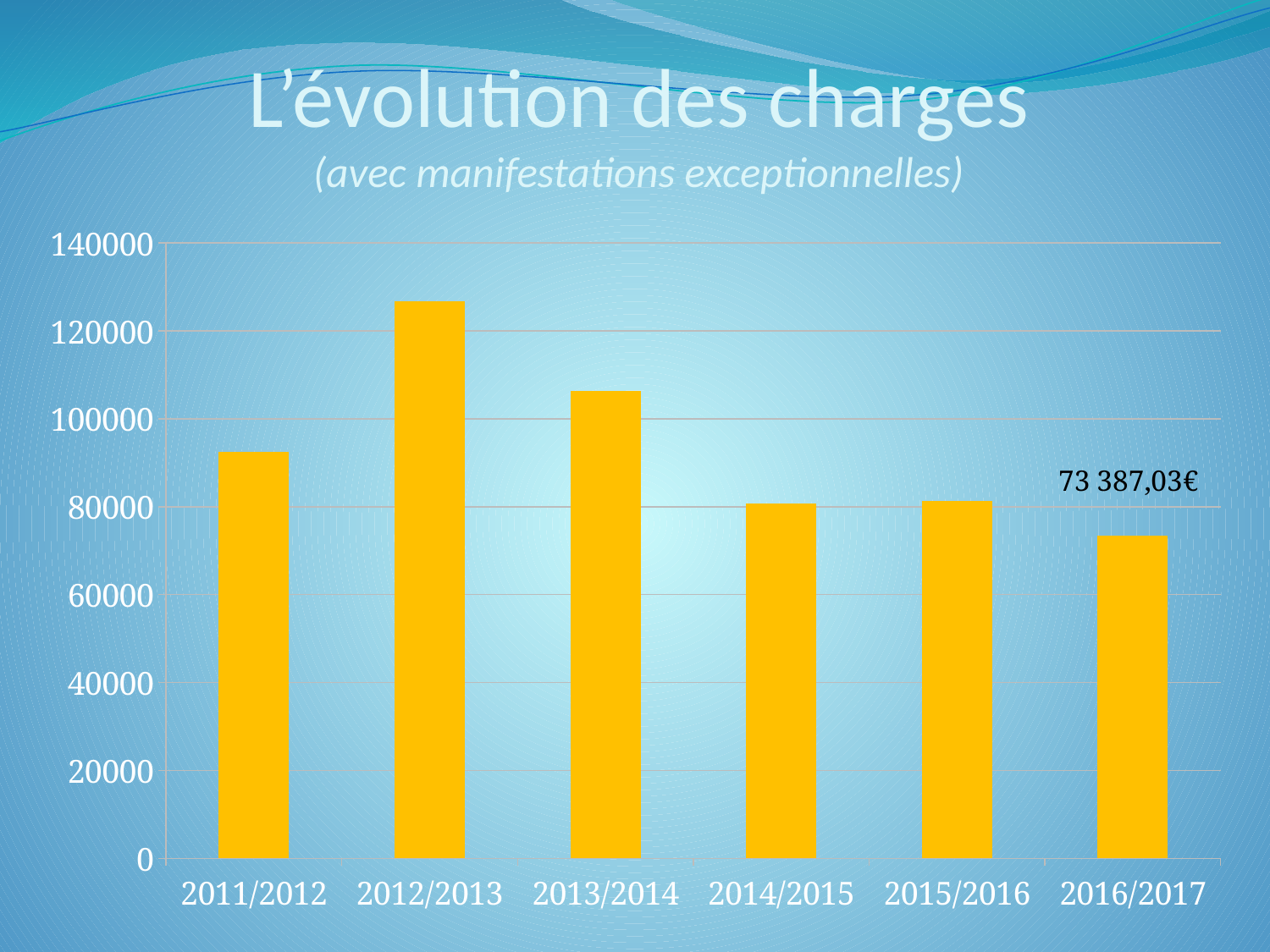
Which is larger, the value for 2011/2012 or the value for 2016/2017? 2011/2012 Which season has the highest charges? 2012/2013 Which season has the lowest charges? 2016/2017 What is the value shown for 2016/2017? 73 387,03€ Is the value for 2012/2013 greater or less than 120000? greater What is the title of the chart on the slide? L'évolution des charges (avec manifestations exceptionnelles) How many categories (seasons) are shown on the x axis? 6 Which is larger, the value for 2012/2013 or the value for 2013/2014? 2012/2013 What type of chart is shown on the slide? bar chart Between 2012/2013 and 2014/2015, do the values rise or fall? fall Is the value for 2011/2012 greater or less than 100000? less Is the value for 2013/2014 greater or less than 100000? greater